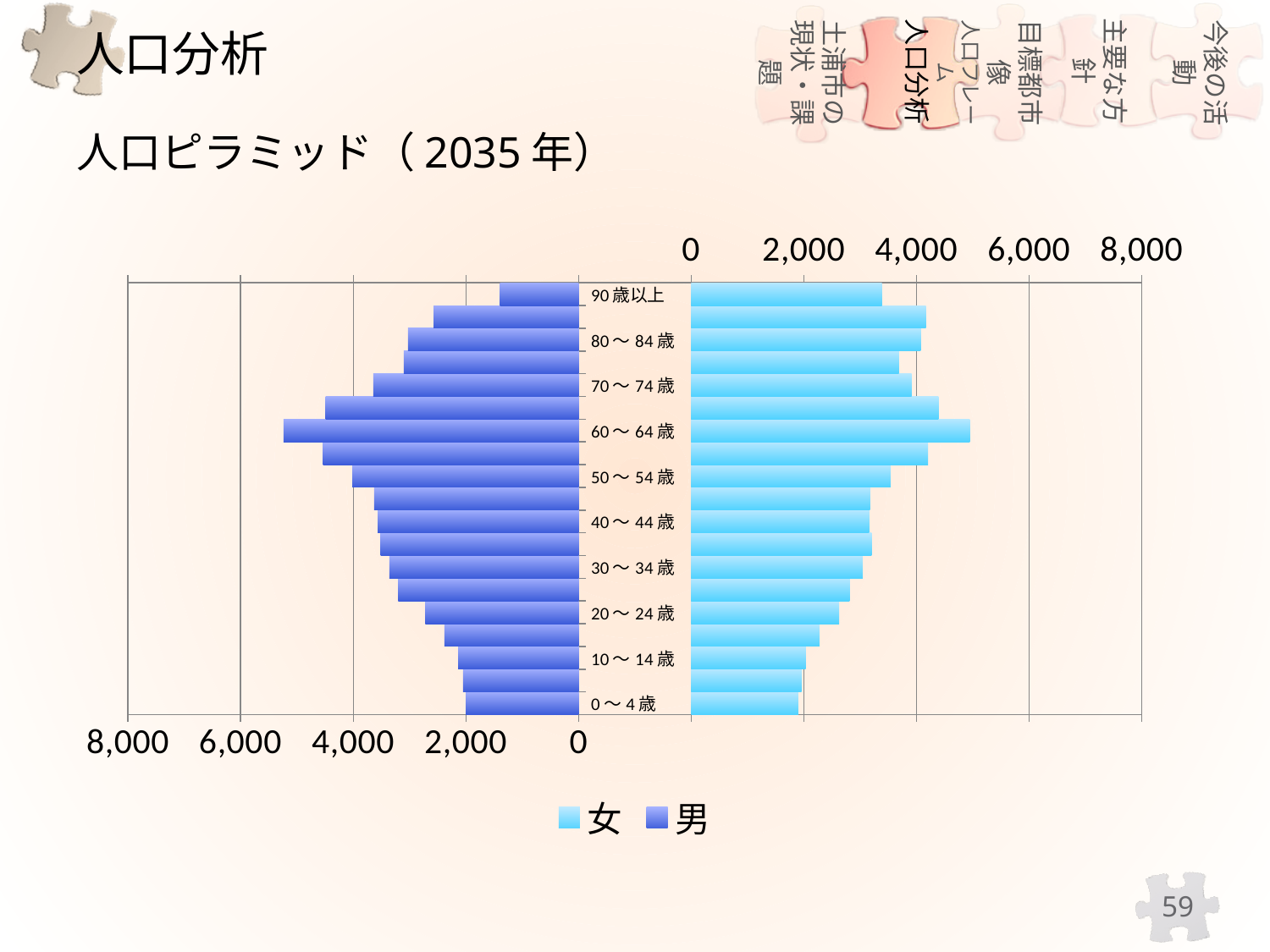
How many series does the legend list? 2 Is the value for 女 in the 90歳以上 group greater or less than 2,000? greater Which series is drawn in the darker blue bars on the left side? 男 What is the title of the chart? 人口ピラミッド（2035年） Is the value for 男 in the 90歳以上 group greater or less than 2,000? less Is the value for 女 in the 40～44歳 group greater or less than 4,000? less Which age group has the longest bar for 男? 60～64歳 Which age group has the longest bar for 女? 60～64歳 For the 90歳以上 group, which is larger, 女 or 男? 女 Which age group has the shortest bar for 男? 90歳以上 What kind of chart is shown on the slide? bar chart